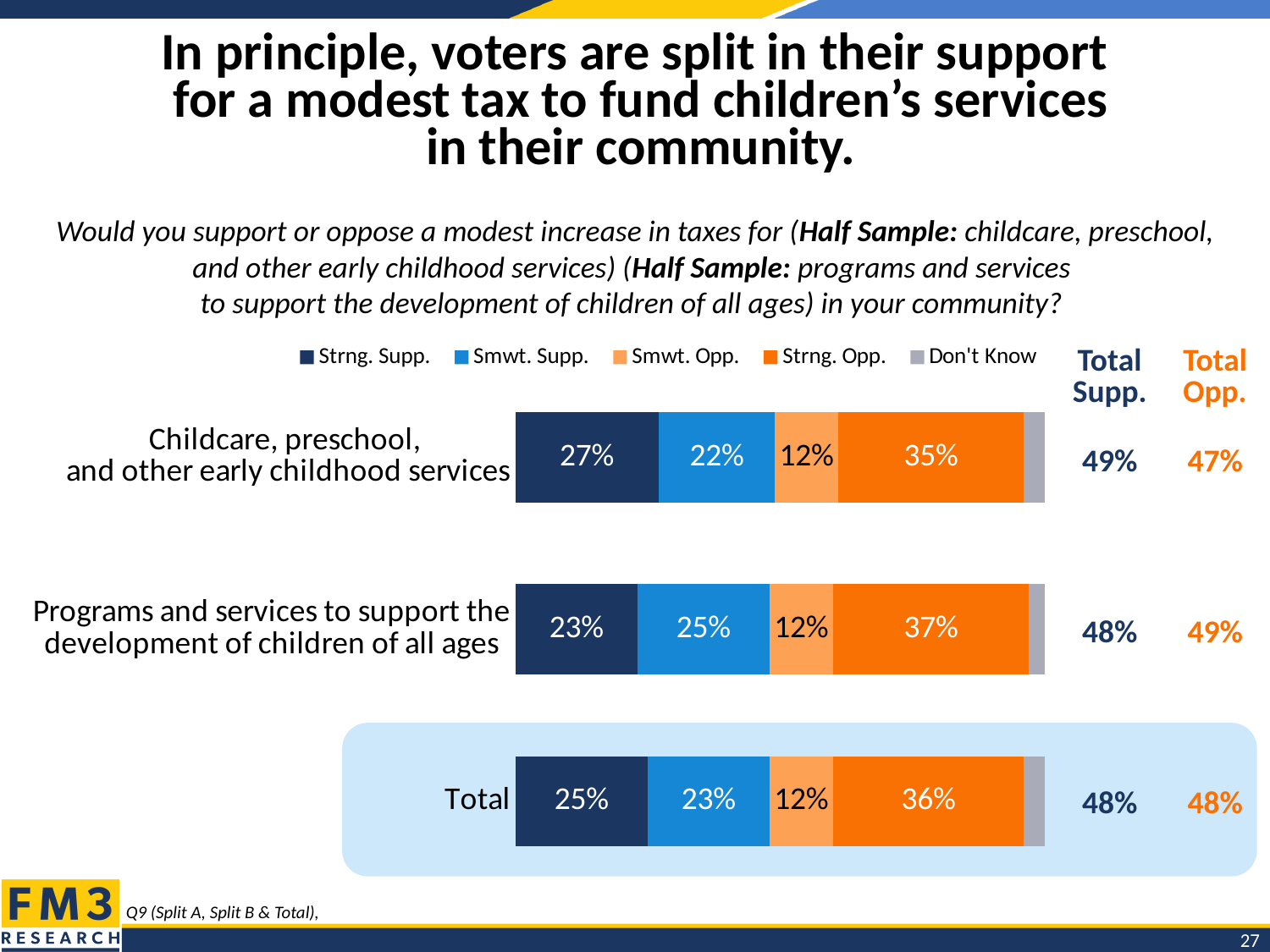
What is the Total Opp. figure shown for "Programs and services to support the development of children of all ages"? 49% What is the difference between the Strng. Opp. value and the Strng. Supp. value for the Total bar? 11 percentage points Which category has the lowest Strng. Opp. value? Childcare, preschool, and other early childhood services How many categories (bars) are plotted in the chart? 3 What is the Smwt. Supp. value for the Total bar? 23% What is the Strng. Supp. value for "Childcare, preschool, and other early childhood services"? 27% How many series does the legend list? 5 Which category has the highest Strng. Supp. value? Childcare, preschool, and other early childhood services What is the Total Supp. figure shown for "Childcare, preschool, and other early childhood services"? 49% What is the Strng. Opp. value for "Programs and services to support the development of children of all ages"? 37% What kind of chart is shown on the slide? Stacked bar chart Which is larger for "Programs and services to support the development of children of all ages": the Smwt. Supp. value or the Strng. Supp. value? Smwt. Supp.